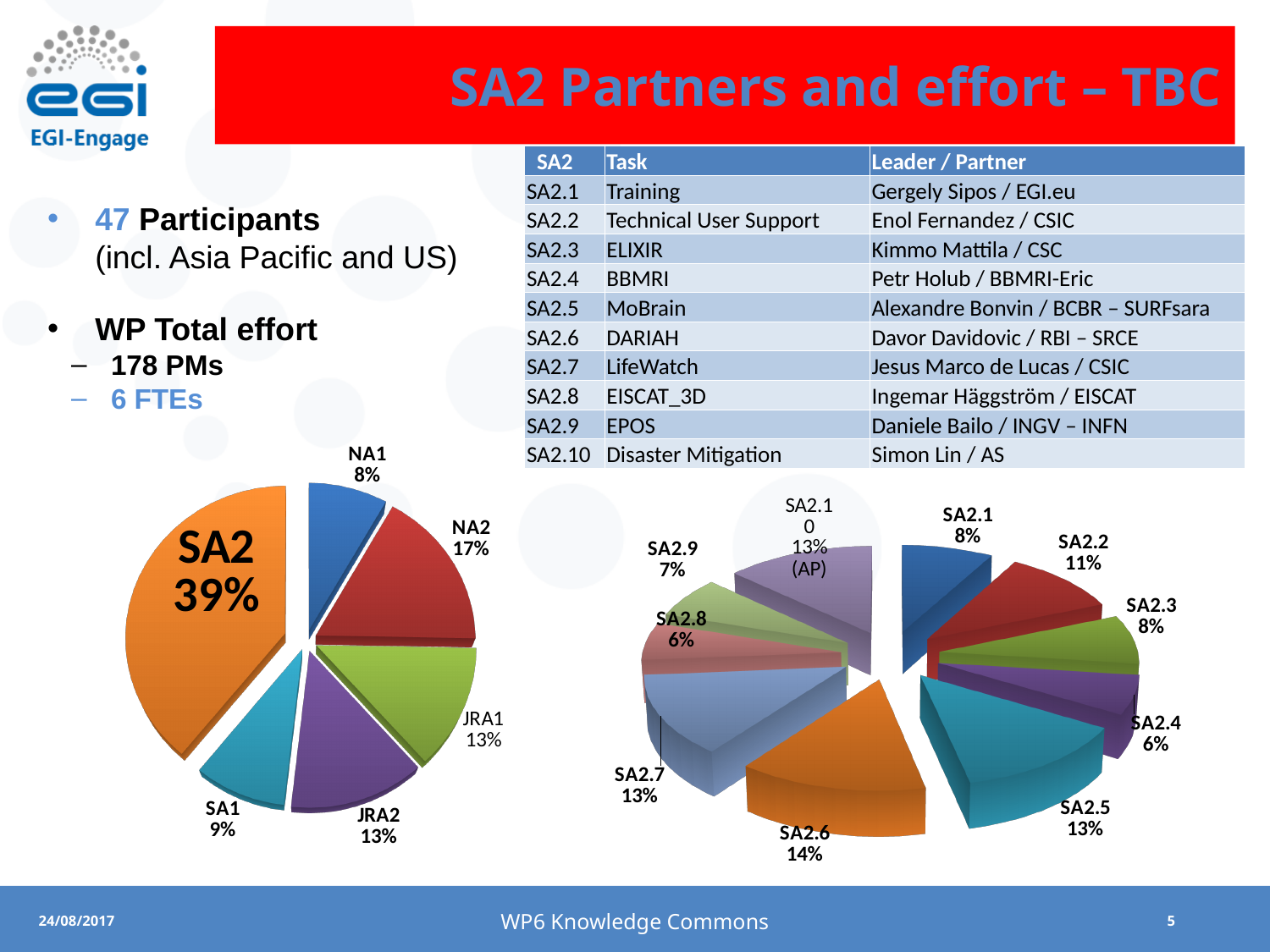
In the left pie chart, which slice is the smallest? NA1 What kind of chart is the chart on the right of the slide? Pie chart In the left pie chart, which slice is the largest? SA2 In the right pie chart, which slice is the largest? SA2.6 In the left pie chart, what share does NA2 have? 17% In the left pie chart, what is the difference between the shares of NA2 and SA1? 8% In the right pie chart, which is larger, SA2.5 or SA2.9? SA2.5 How many slices does the left pie chart have? 6 How many slices does the right pie chart have? 10 In the right pie chart, what share does SA2.2 have? 11% In the left pie chart, what share does SA2 have? 39% In the right pie chart, what share does SA2.6 have? 14%